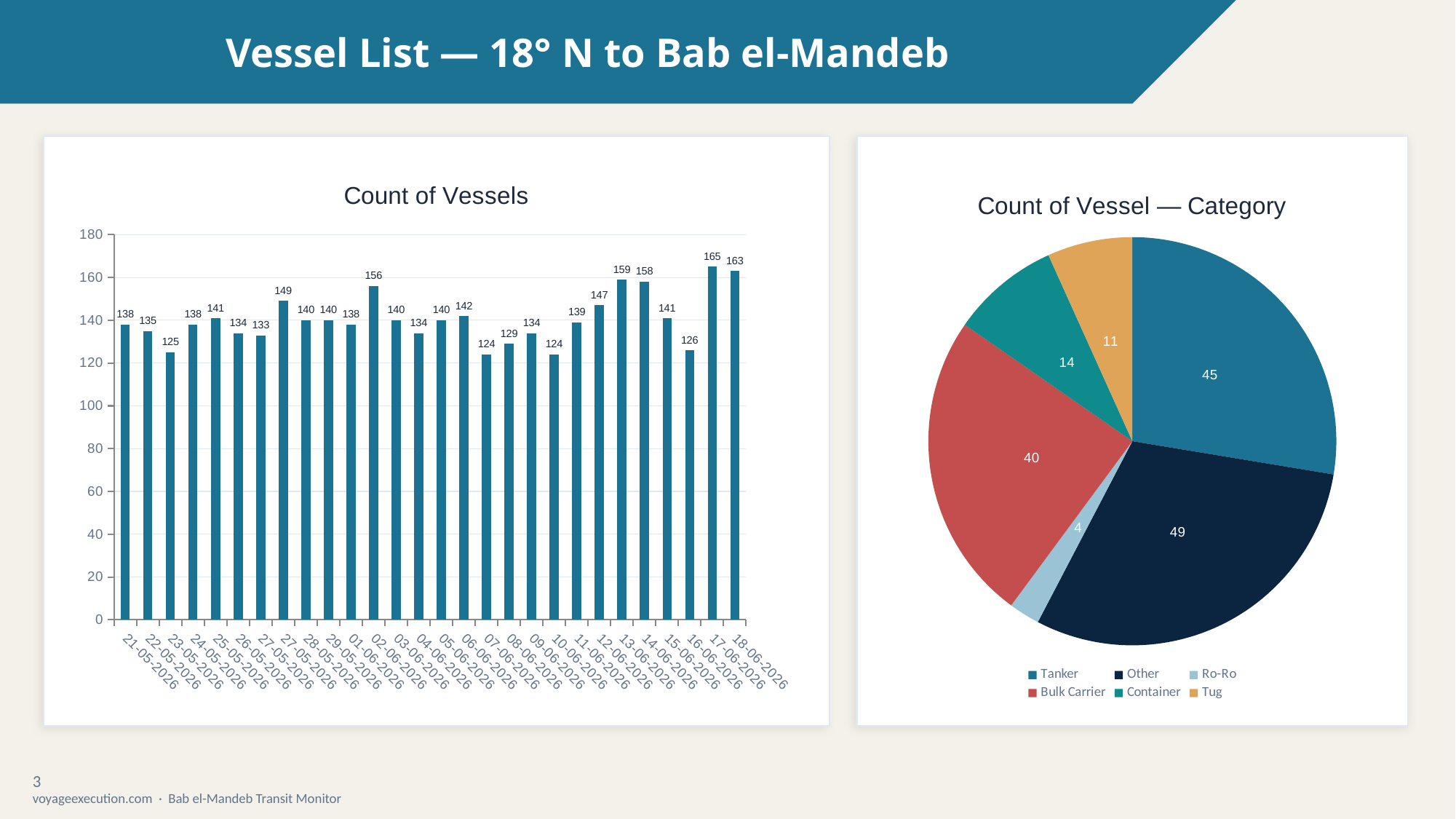
In the 'Count of Vessels' chart, is the value for 23-05-2026 greater or less than 140? less In the 'Count of Vessels' chart, which is larger, the value for 12-06-2026 or 13-06-2026? 13-06-2026 How many bars are plotted in the 'Count of Vessels' chart? 28 In the 'Count of Vessel — Category' pie chart, which category has the largest slice? Other In the 'Count of Vessels' chart, what is the value for 02-06-2026? 156 In the 'Count of Vessel — Category' pie chart, what is the value for Bulk Carrier? 40 How many categories does the legend of the 'Count of Vessel — Category' pie chart list? 6 What kind of chart is the 'Count of Vessels' chart on the left? bar chart In the 'Count of Vessels' chart, which date has the highest count? 17-06-2026 In the 'Count of Vessels' chart, what is the difference between the values for 17-06-2026 and 16-06-2026? 39 In the 'Count of Vessel — Category' pie chart, which category has the smallest slice? Ro-Ro In the 'Count of Vessels' chart, what is the lowest value shown? 124